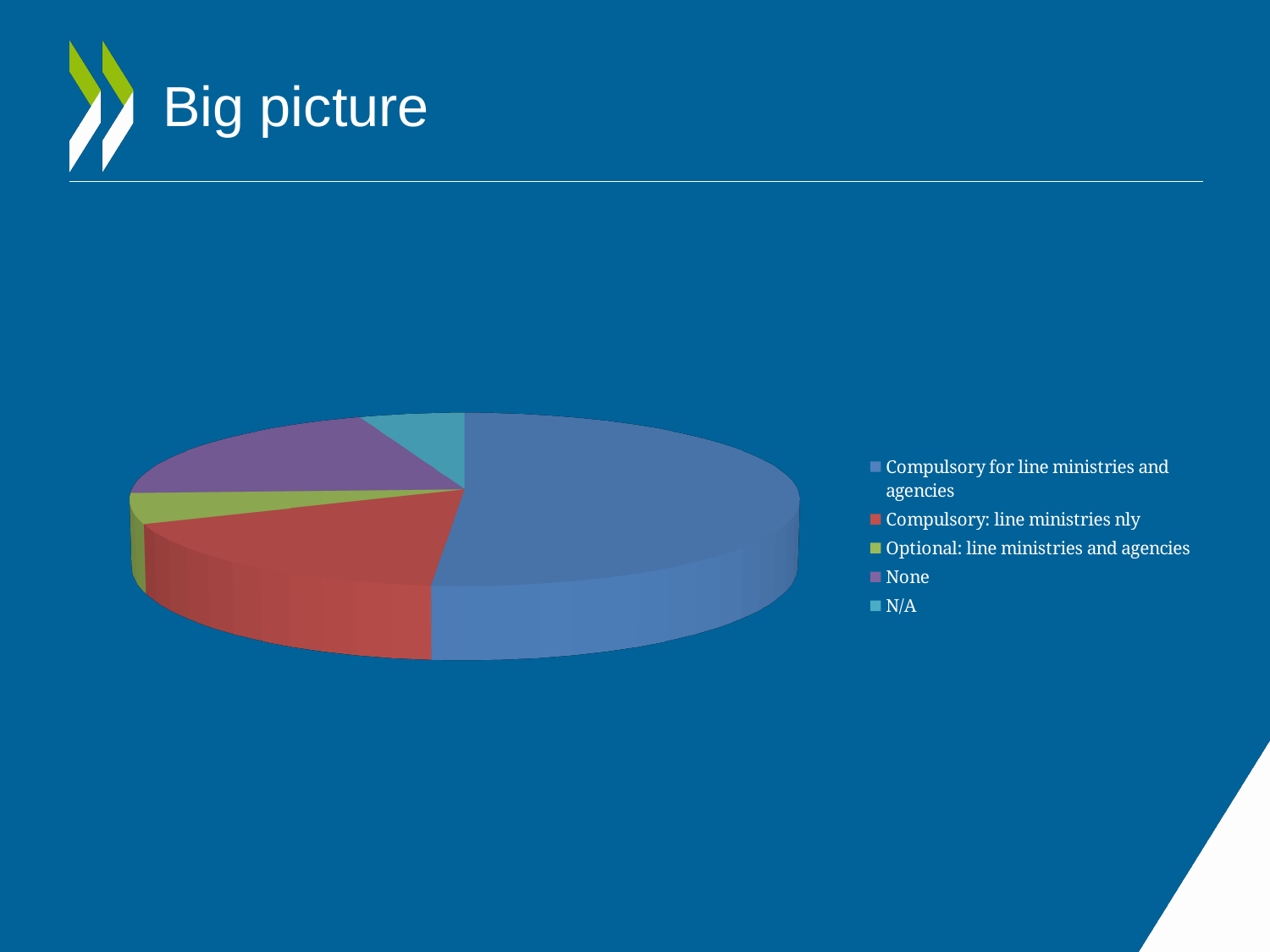
How many categories does the pie chart have? 5 What kind of chart is shown on the slide? pie chart What is the title of the slide containing the pie chart? Big picture Which slice is larger: 'Compulsory for line ministries and agencies' or 'Compulsory: line ministries nly'? Compulsory for line ministries and agencies Which slice is larger: 'None' or 'N/A'? None How many entries does the legend of the pie chart list? 5 What colour is the 'None' slice in the pie chart? purple Which category has the largest slice of the pie chart? Compulsory for line ministries and agencies